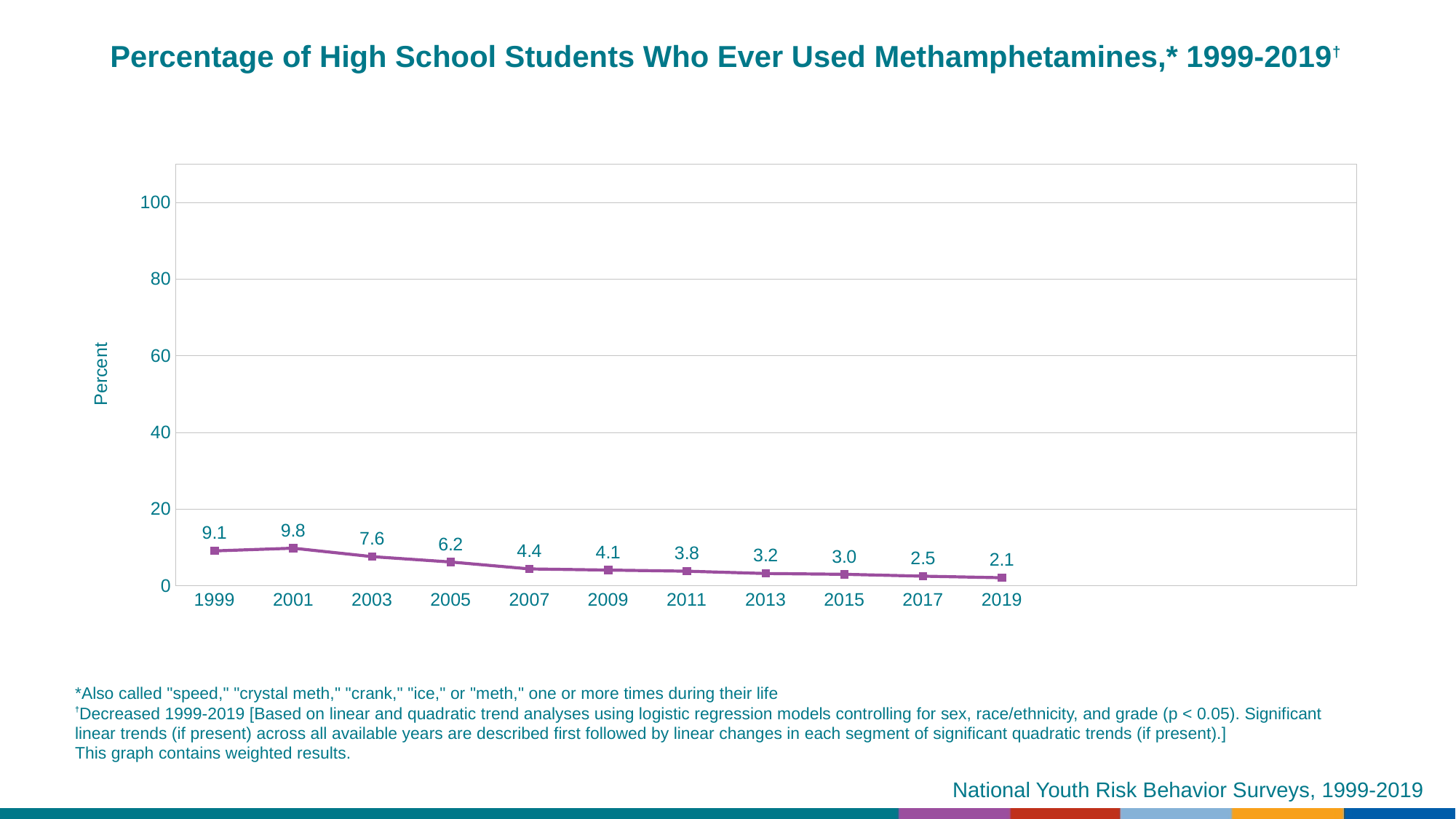
What is the value plotted for 2019? 2.1 What is the value plotted for 2011? 3.8 Which year has a larger value, 2005 or 2013? 2005 Which year has the highest percentage of students who ever used methamphetamines? 2001 What is the difference between the values for 2001 and 2019? 7.7 Which year has the lowest percentage of students who ever used methamphetamines? 2019 Is the value for 2001 greater or less than 20? less What percentage of high school students had ever used methamphetamines in 1999? 9.1 Do the values generally rise or fall from 2001 to 2019? fall What kind of chart is shown on the slide? line chart How many years are plotted on the chart? 11 What is the difference between the values for 1999 and 2003? 1.5